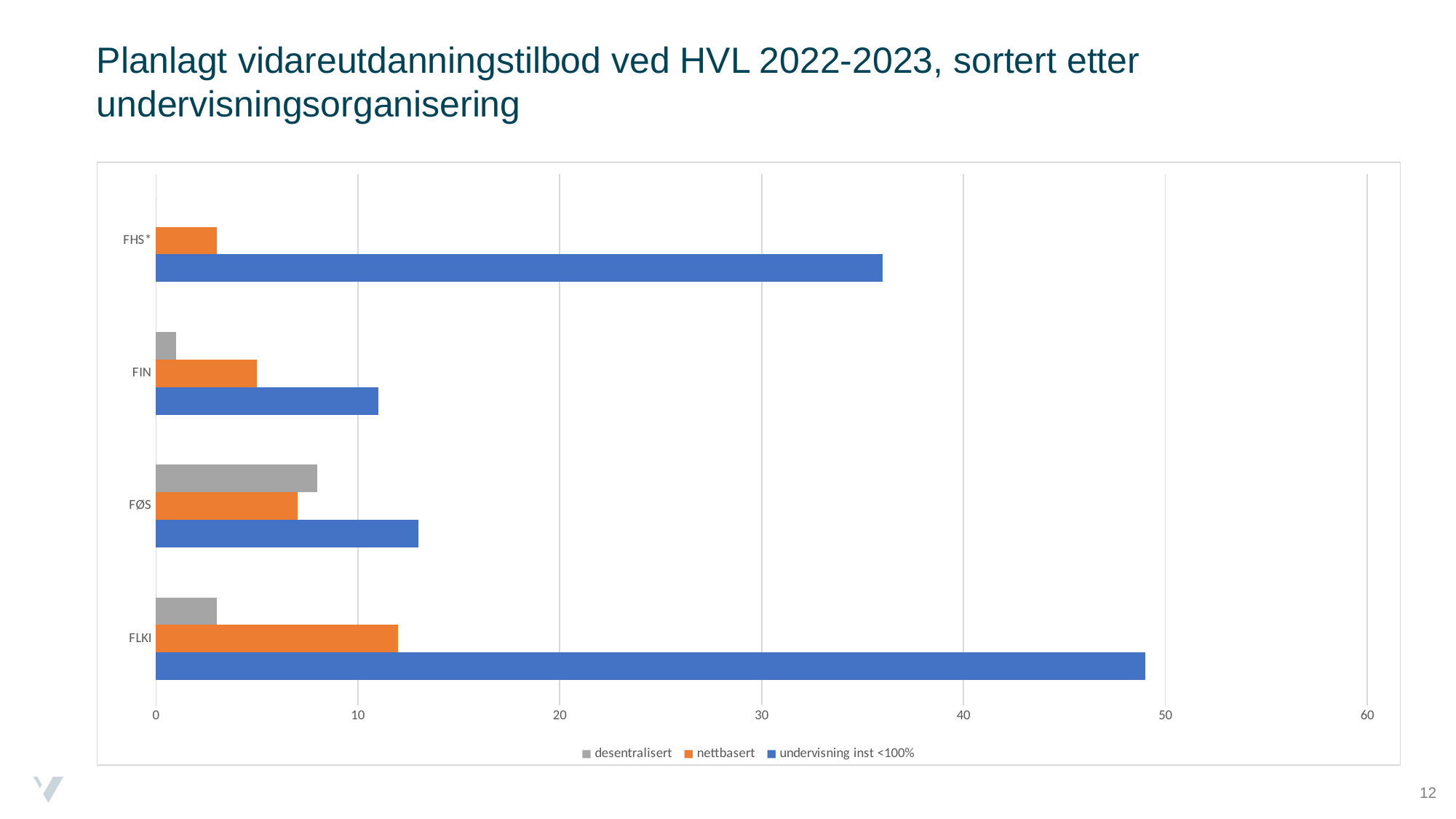
How many categories are shown on the vertical axis of the chart? 4 Is the 'undervisning inst <100%' value for FHS* greater or less than 30? greater What kind of chart is shown on the slide? bar chart Is the 'undervisning inst <100%' value for FIN greater or less than 20? less Which series is shown in orange in the chart? nettbasert Which category has the highest value for the 'nettbasert' series? FLKI How many series does the legend list? 3 Which is larger: the 'undervisning inst <100%' value for FLKI or for FHS*? FLKI Is the 'desentralisert' value for FØS greater or less than 10? less Which category has the highest value for the 'undervisning inst <100%' series? FLKI Which category has the highest value for the 'desentralisert' series? FØS